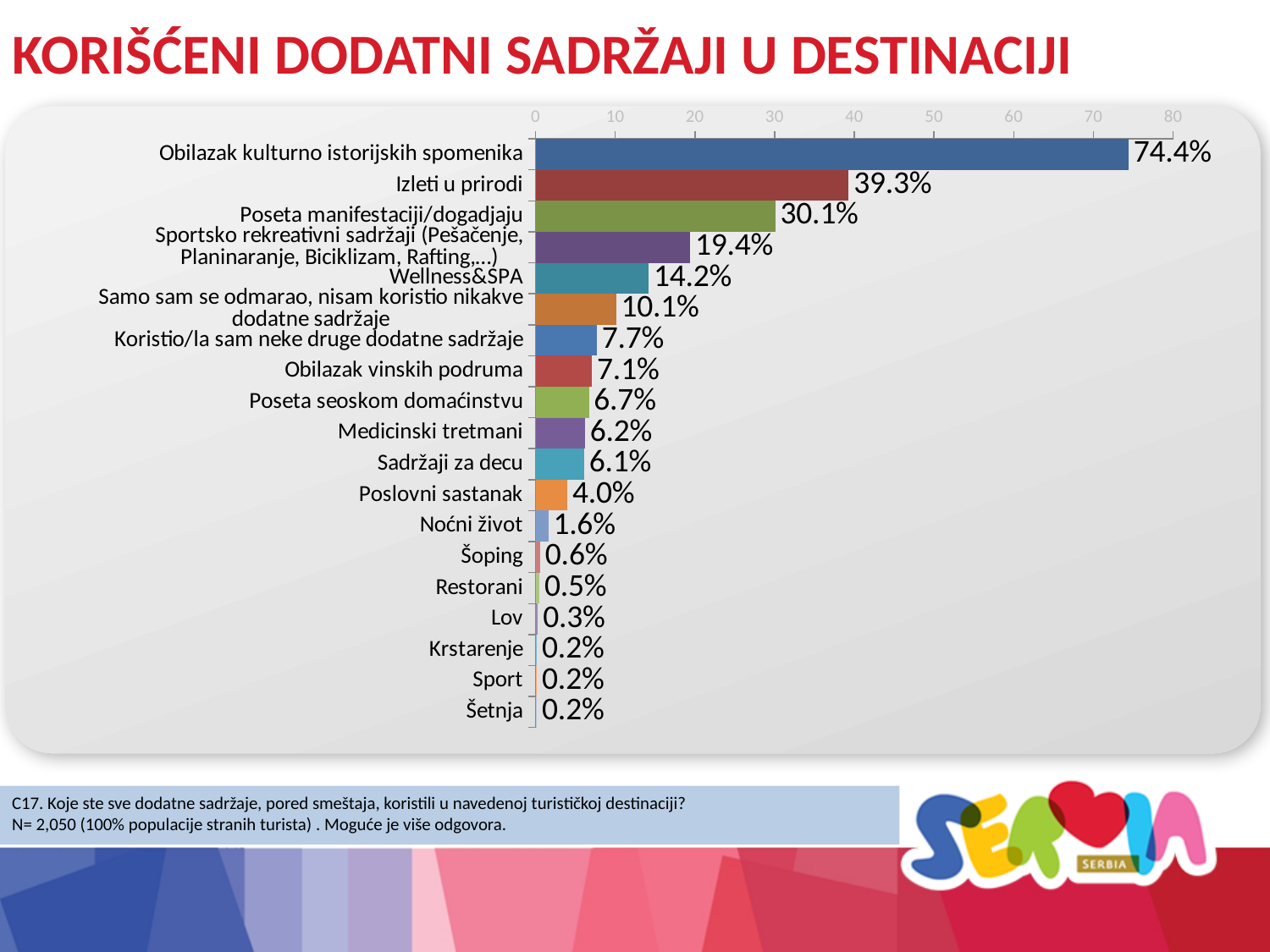
What is the value for Noćni život? 1.6% What is the value for Obilazak kulturno istorijskih spomenika? 74.4% Which category has the highest value? Obilazak kulturno istorijskih spomenika Is the value for Izleti u prirodi greater or less than 30? greater What is the difference between the values for Poseta manifestaciji/dogadjaju and Wellness&SPA? 15.9% What is the value for Wellness&SPA? 14.2% How many categories are shown in the chart? 19 What is the value for Poslovni sastanak? 4.0% Which is larger, the value for Medicinski tretmani or the value for Poslovni sastanak? Medicinski tretmani What is the value for Izleti u prirodi? 39.3% What is the difference between the values for Obilazak kulturno istorijskih spomenika and Izleti u prirodi? 35.1% What kind of chart is shown on the slide? bar chart